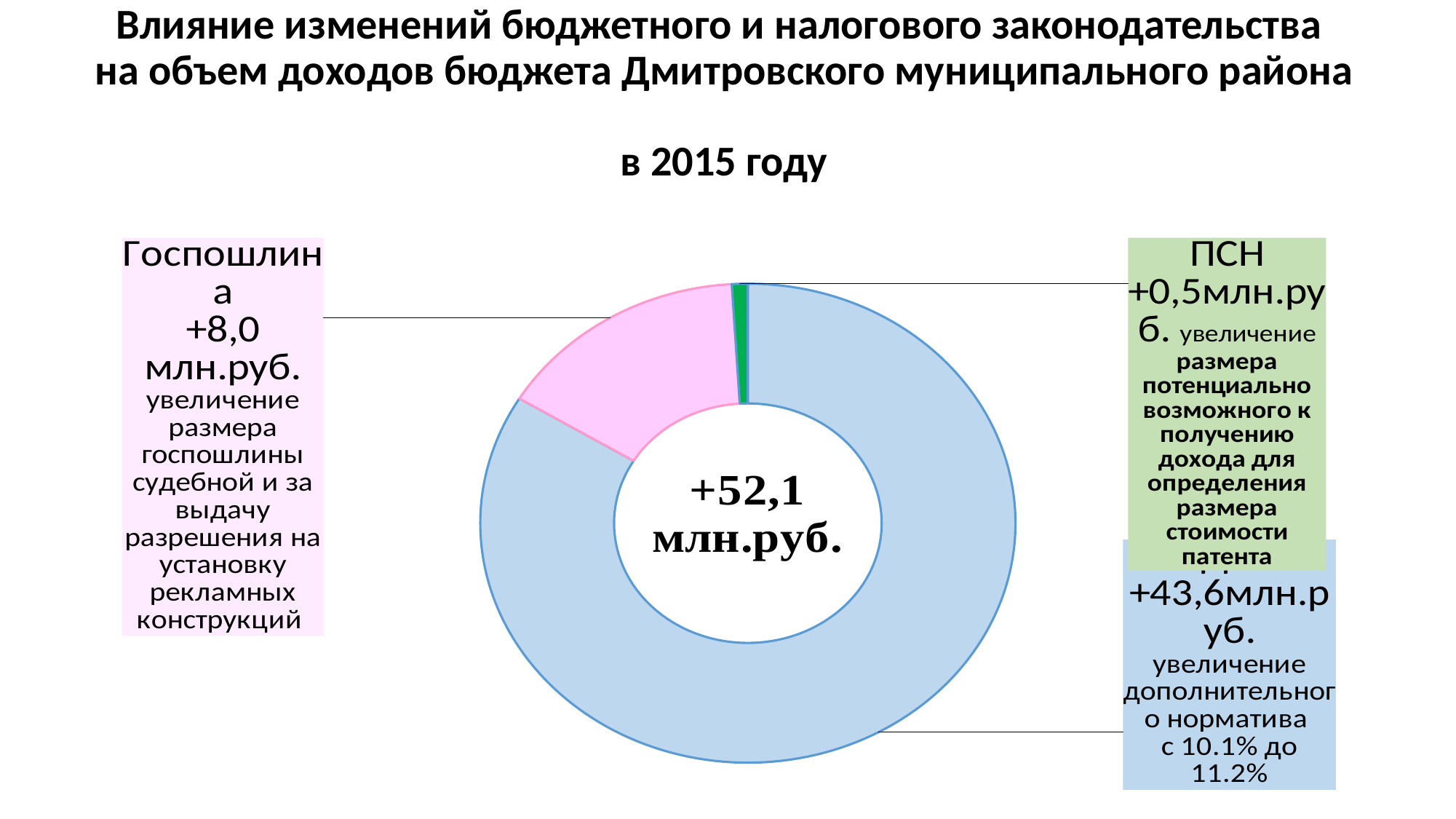
What value is shown for Госпошлина? +8,0 млн.руб. What value is shown for ПСН? +0,5 млн.руб. Which year does the chart title refer to? 2015 What kind of chart is shown on the slide? Doughnut (pie) chart What is the difference between the Госпошлина value and the ПСН value? 7,5 млн.руб. Which slice of the doughnut is the largest? The blue slice (+43,6 млн.руб.) How many slices does the doughnut chart have? 3 What total value is shown in the centre of the doughnut chart? +52,1 млн.руб. Which is larger, the value for Госпошлина or the value for ПСН? Госпошлина Which slice of the doughnut is the smallest? ПСН (+0,5 млн.руб.) What value is shown for the large blue slice of the doughnut? +43,6 млн.руб. What colour is the Госпошлина slice of the doughnut? Pink